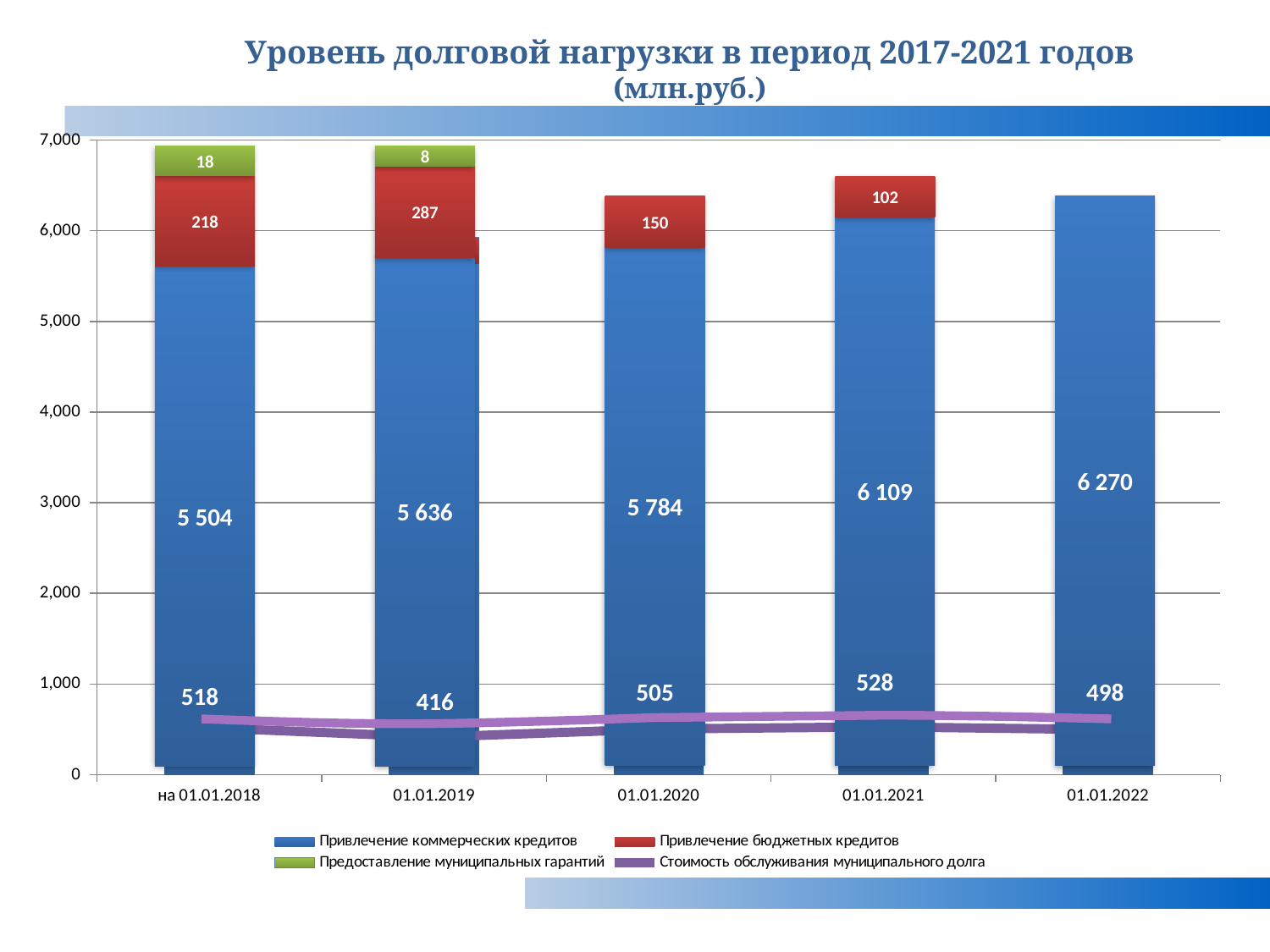
Which date has the highest value for Привлечение коммерческих кредитов? 01.01.2022 How many series does the legend list? 4 Which date has the lowest value for Стоимость обслуживания муниципального долга? 01.01.2019 Which is larger: Привлечение бюджетных кредитов on 01.01.2018 or on 01.01.2020? 01.01.2018 What is the value of Привлечение коммерческих кредитов on 01.01.2020? 5 784 What is the value of Предоставление муниципальных гарантий on 01.01.2018? 18 What is the value of Стоимость обслуживания муниципального долга on 01.01.2021? 528 What type of chart is shown on the slide? combination bar and line chart (stacked bars with a line) Do the values for Привлечение коммерческих кредитов rise or fall from 01.01.2018 to 01.01.2022? rise What is the value of Привлечение бюджетных кредитов on 01.01.2019? 287 What is the difference between Привлечение коммерческих кредитов on 01.01.2022 and on 01.01.2021? 161 How many dates are shown on the x axis? 5